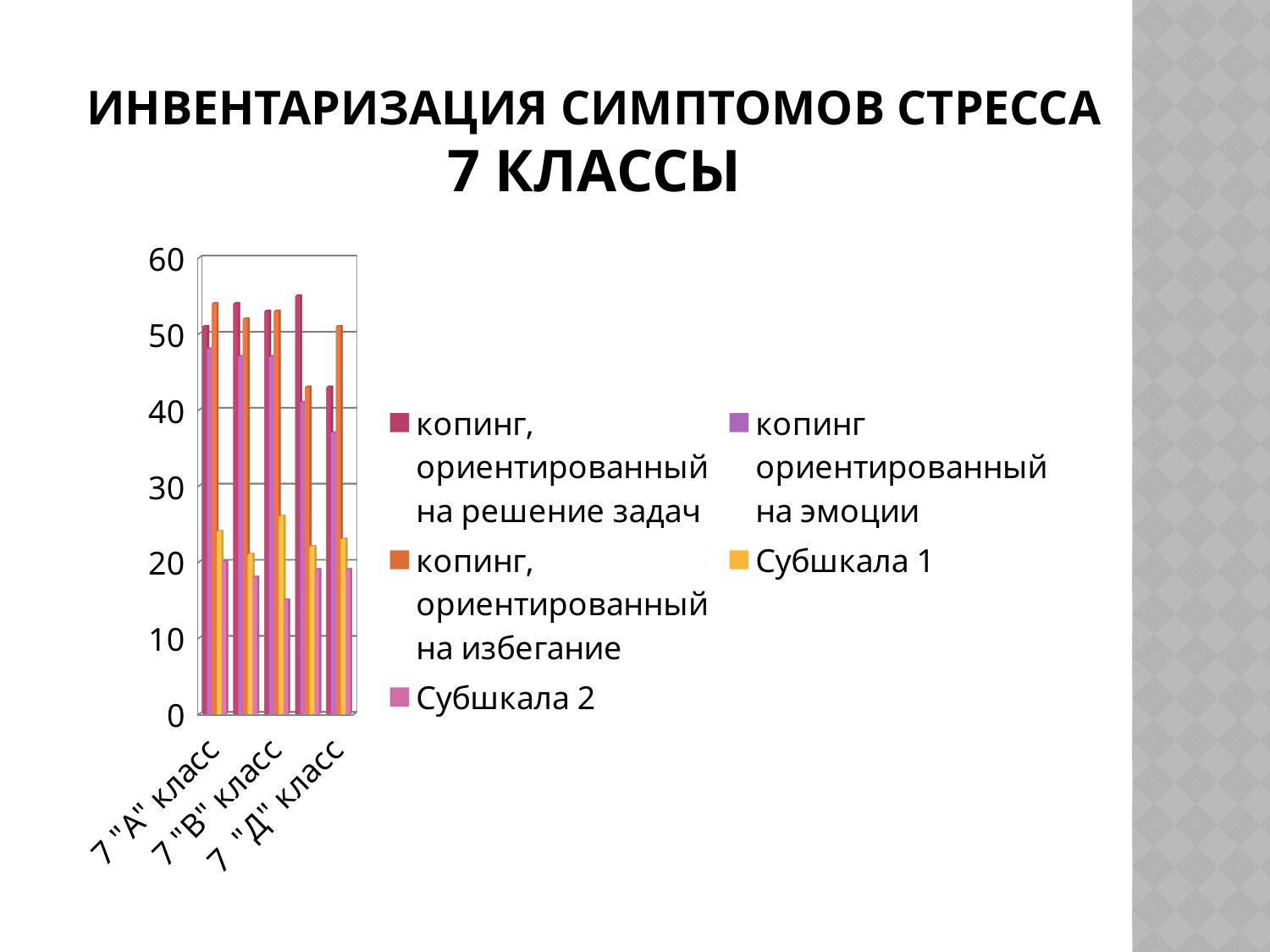
Which series has the lowest bar in every group of bars? Субшкала 2 What is the highest value shown on the vertical axis? 60 How many series does the legend list? 5 Are all the values for копинг, ориентированный на решение задач greater or less than 40? greater Are all the values for Субшкала 1 greater or less than 30? less Which legend entry is shown in yellow? Субшкала 1 Are all the values for Субшкала 2 greater or less than 30? less In each group of bars, which is larger: Субшкала 1 or Субшкала 2? Субшкала 1 What is the title of the slide containing the chart? ИНВЕНТАРИЗАЦИЯ СИМПТОМОВ СТРЕССА 7 КЛАССЫ What kind of chart is shown on the slide? bar chart